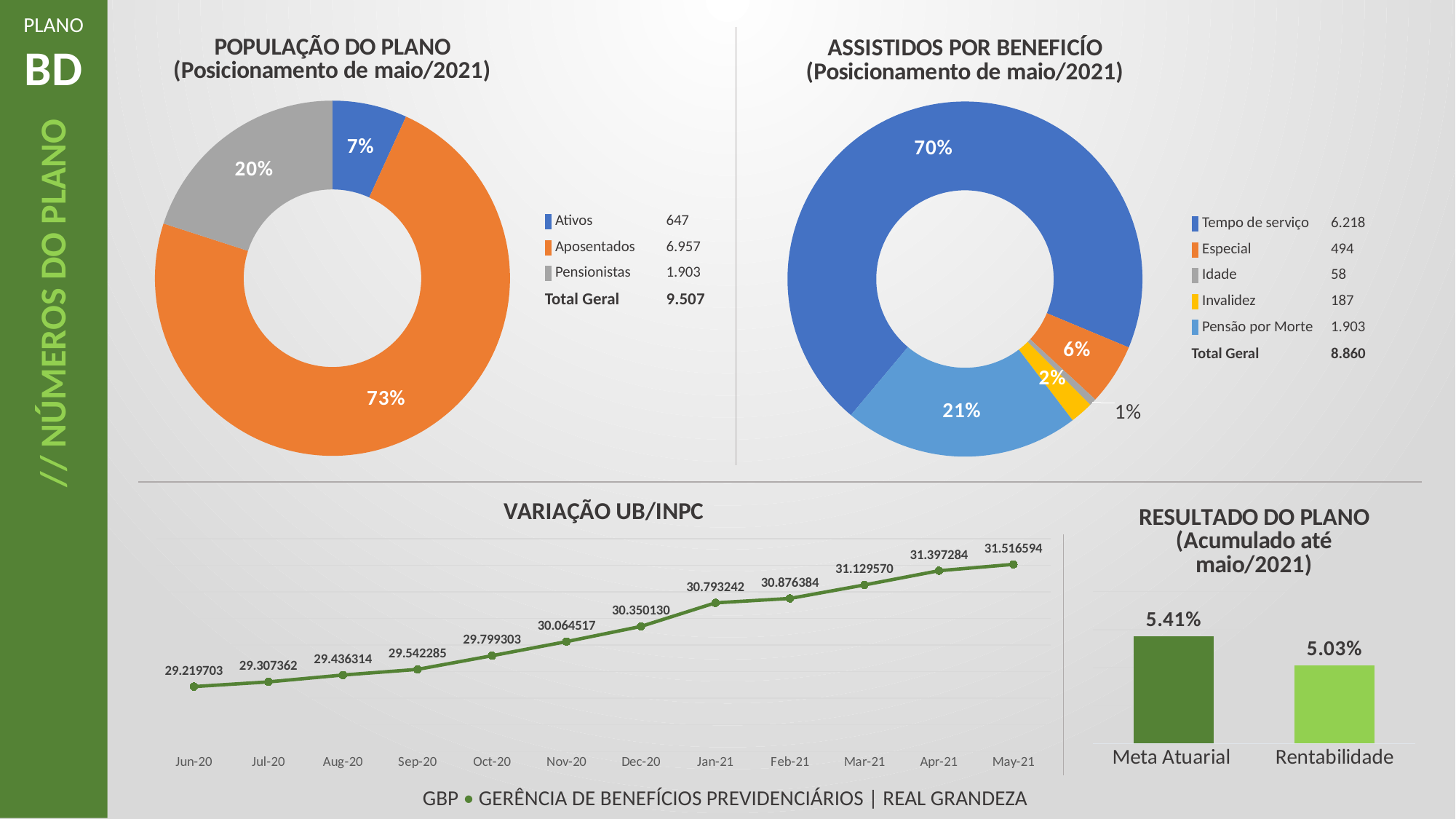
In the VARIAÇÃO UB/INPC chart, how many data points are plotted? 12 In the POPULAÇÃO DO PLANO chart, what is the Total Geral? 9.507 In the ASSISTIDOS POR BENEFICÍO chart, which is larger, Especial or Invalidez? Especial In the VARIAÇÃO UB/INPC chart, do the values rise or fall from Jun-20 to May-21? rise In the POPULAÇÃO DO PLANO chart, which category has the smallest share? Ativos In the POPULAÇÃO DO PLANO chart, what share of the plan population is Aposentados? 73% In the ASSISTIDOS POR BENEFICÍO chart, how many categories does the legend list (excluding Total Geral)? 5 In the RESULTADO DO PLANO chart, what is the difference between Meta Atuarial and Rentabilidade? 0.38% In the POPULAÇÃO DO PLANO chart, how many Pensionistas are listed in the legend? 1.903 In the VARIAÇÃO UB/INPC chart, what is the value for May-21? 31.516594 In the ASSISTIDOS POR BENEFICÍO chart, what share does Pensão por Morte represent? 21% In the ASSISTIDOS POR BENEFICÍO chart, what is the value for Tempo de serviço? 6.218